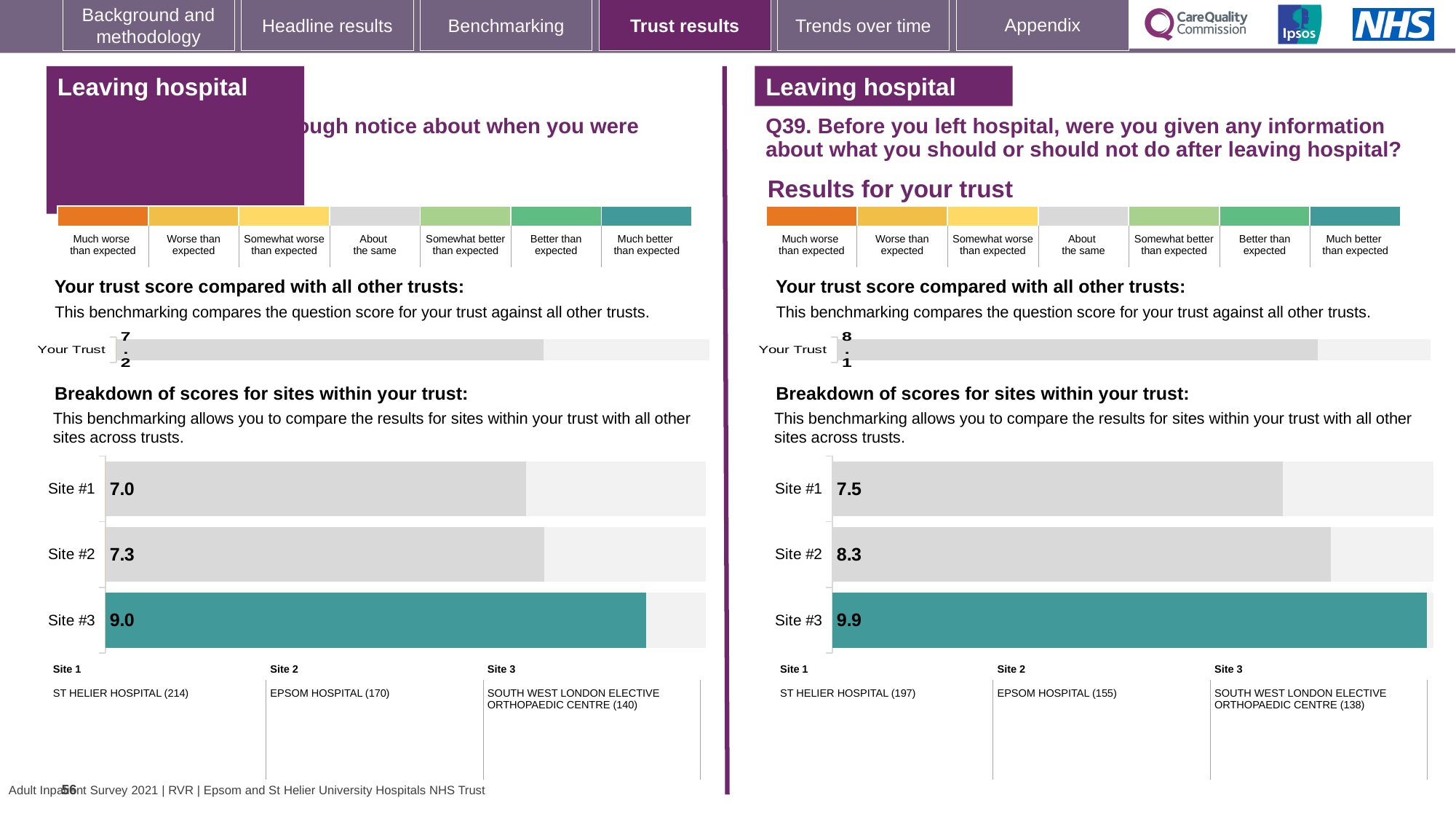
In the left-hand site breakdown chart, what is the score for Site #3? 9.0 How many sites are shown in the right-hand (Q39) site breakdown chart? 3 What type of chart is used for the site breakdown on the right-hand (Q39) side of the slide? Bar chart In the right-hand (Q39) site breakdown chart, what is the score for Site #3? 9.9 In the left-hand 'Breakdown of scores for sites within your trust' chart, what is the score for Site #1? 7.0 In the right-hand (Q39) site breakdown chart, which site has the lowest score? Site #1 In the left-hand site breakdown chart, which site has the highest score? Site #3 In the left-hand site breakdown chart, which has the larger score, Site #1 or Site #2? Site #2 In the right-hand (Q39) site breakdown chart, what is the score for Site #2? 8.3 In the right-hand (Q39) site breakdown chart, what is the difference between the scores for Site #3 and Site #1? 2.4 In the left-hand 'Your trust score compared with all other trusts' chart, what is the score shown for Your Trust? 7.2 In the right-hand (Q39) 'Your trust score compared with all other trusts' chart, what is the score shown for Your Trust? 8.1